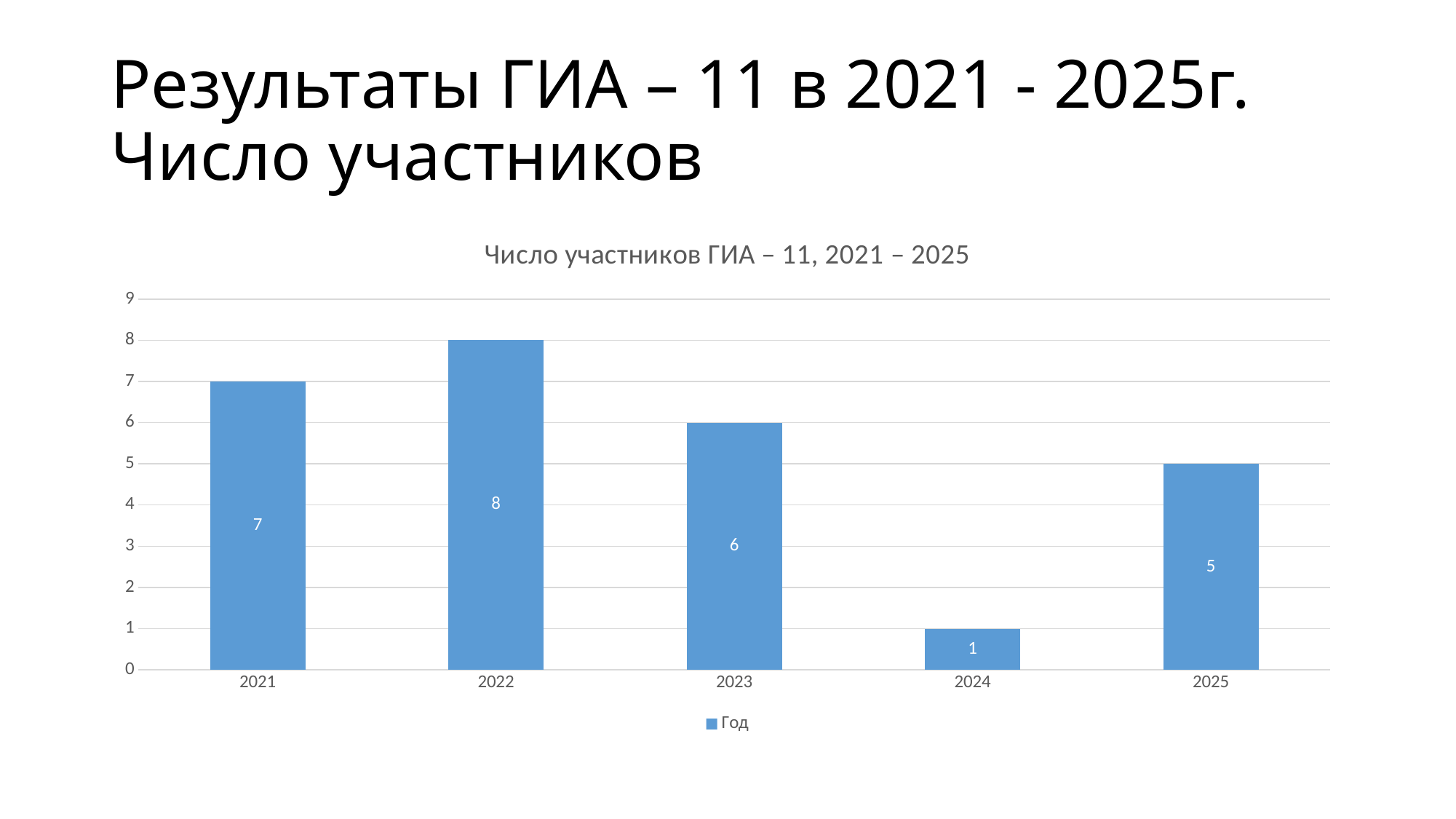
How many years are shown on the x axis? 5 What is the title of the chart? Число участников ГИА – 11, 2021 – 2025 What is the number of participants for 2025? 5 How many series does the legend list? 1 Which year has the highest number of participants? 2022 What is the difference between the number of participants in 2021 and 2024? 6 Which year has more participants, 2023 or 2025? 2023 What is the number of participants for 2021? 7 What kind of chart is shown on the slide? Bar chart Which year has the lowest number of participants? 2024 What is the number of participants for 2024? 1 What is the difference between the number of participants in 2022 and 2023? 2